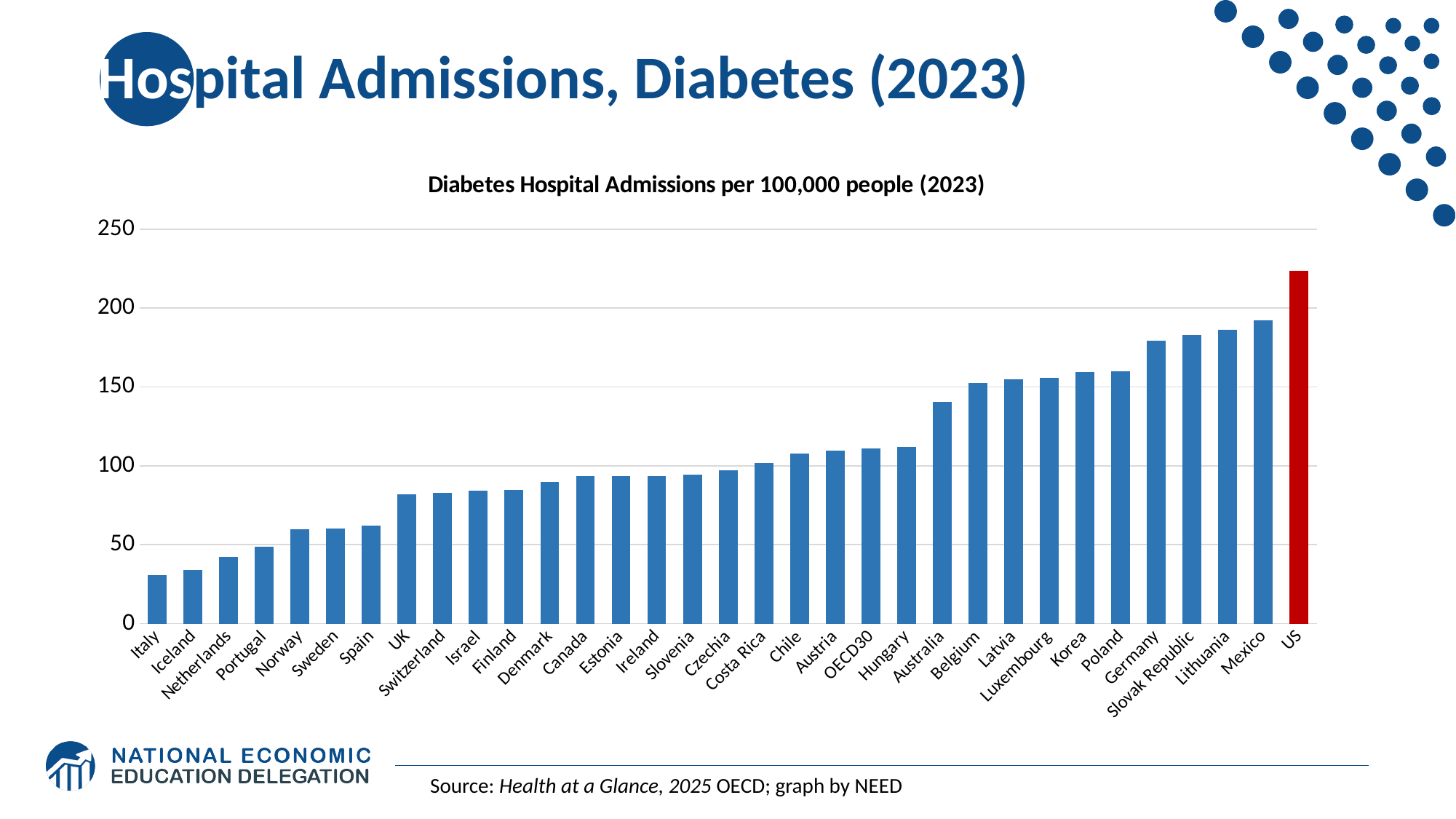
Is the value for Denmark greater or less than 100? less What kind of chart is shown on the slide? bar chart Is the value for Germany greater or less than 150? greater Is the value for the US greater or less than 200? greater Which has a higher value, the US or Mexico? US Which bar is coloured red rather than blue? US Which country has the lowest diabetes hospital admissions per 100,000 people? Italy Do the values rise or fall moving from left to right along the x axis? rise Which country has the highest diabetes hospital admissions per 100,000 people? US How many bars (countries and groups) are plotted in the chart? 33